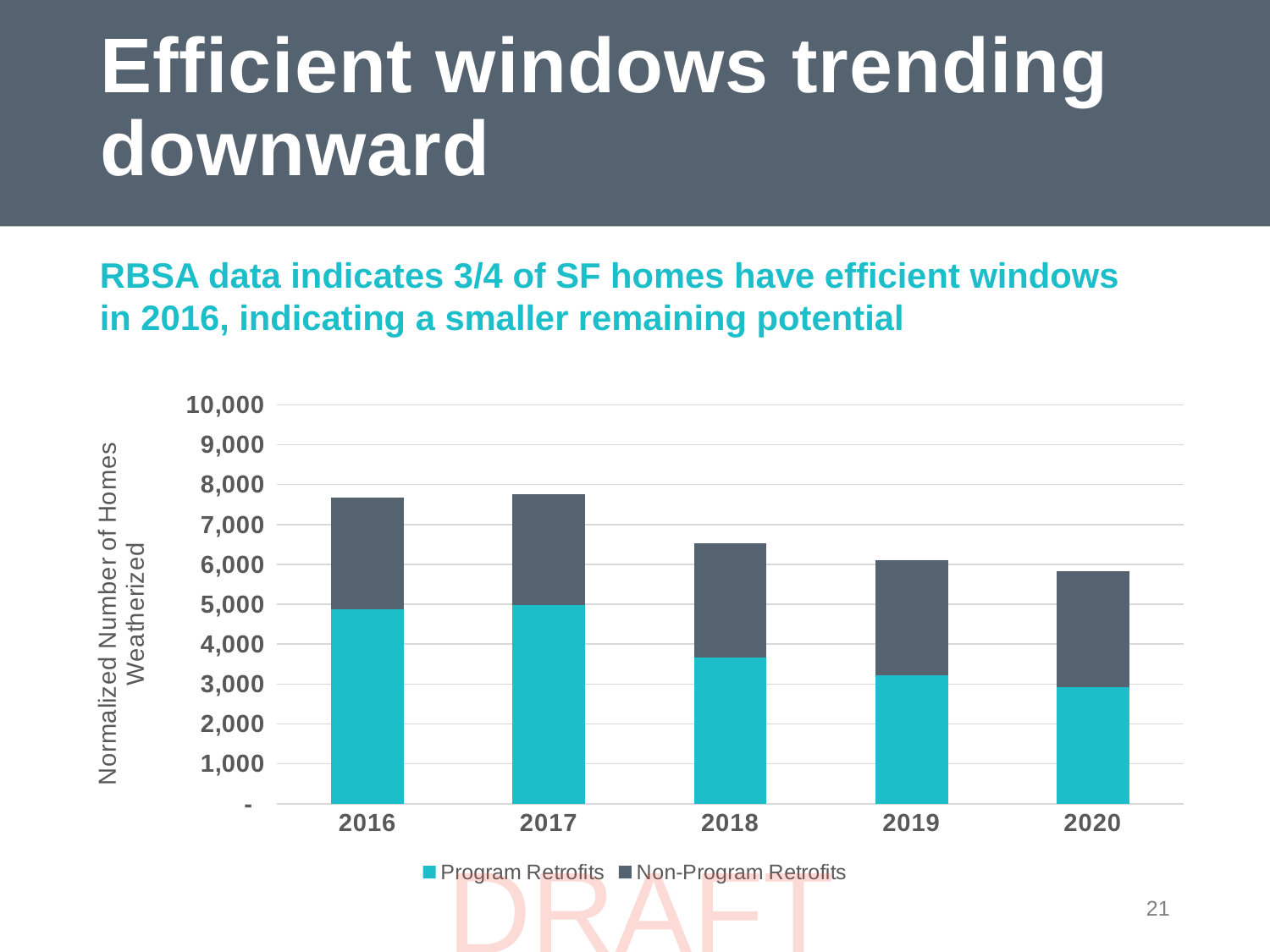
Is the Program Retrofits value for 2020 greater or less than 4,000? less Is the Program Retrofits value for 2017 greater or less than 4,000? greater How many series does the chart's legend list? 2 Do the total bar heights generally rise or fall from 2017 to 2020? fall Is the total bar for 2018 larger or smaller than the total bar for 2017? smaller Which year has the lowest value for Program Retrofits? 2020 Is the total bar height for 2016 greater or less than 7,000? greater How many years are shown on the x axis of the chart? 5 What kind of chart is shown on the slide? stacked bar chart Which year has the lowest total normalized number of homes weatherized? 2020 What is the label on the chart's vertical axis? Normalized Number of Homes Weatherized